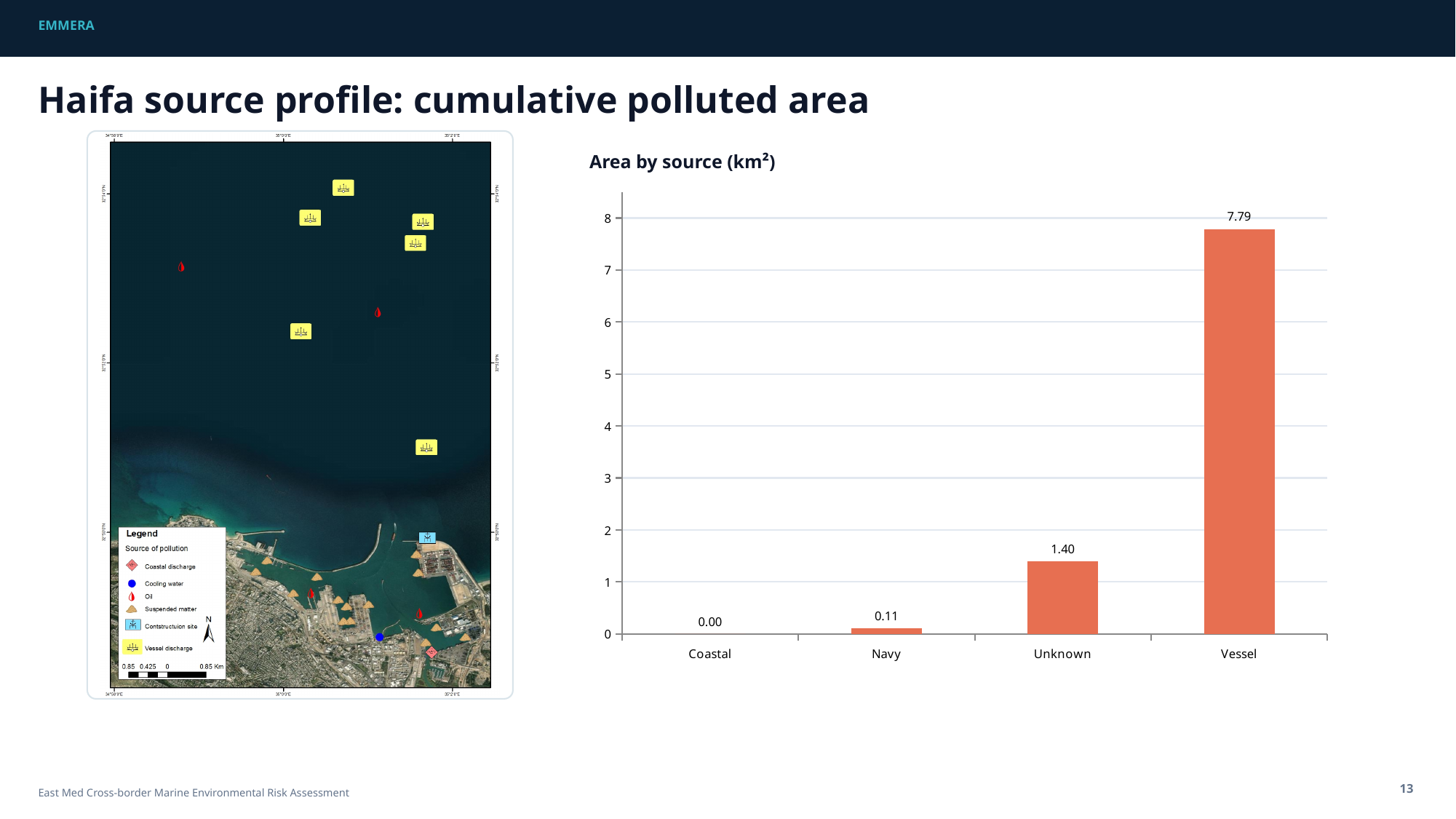
Which source has the highest area in the Area by source (km²) chart? Vessel What is the difference between the Vessel and Unknown values in the Area by source (km²) chart? 6.39 What is the value for Coastal in the Area by source (km²) chart? 0.00 Is the value for Vessel in the Area by source (km²) chart greater or less than 7? greater What is the value for Navy in the Area by source (km²) chart? 0.11 Which source has the lowest area in the Area by source (km²) chart? Coastal What is the value for Unknown in the Area by source (km²) chart? 1.40 How many source categories are shown in the Area by source (km²) chart? 4 What kind of chart is the Area by source (km²) chart? Bar chart Which is larger in the Area by source (km²) chart, Navy or Unknown? Unknown What is the title of the chart on the right of the slide? Area by source (km²) What is the value for Vessel in the Area by source (km²) chart? 7.79